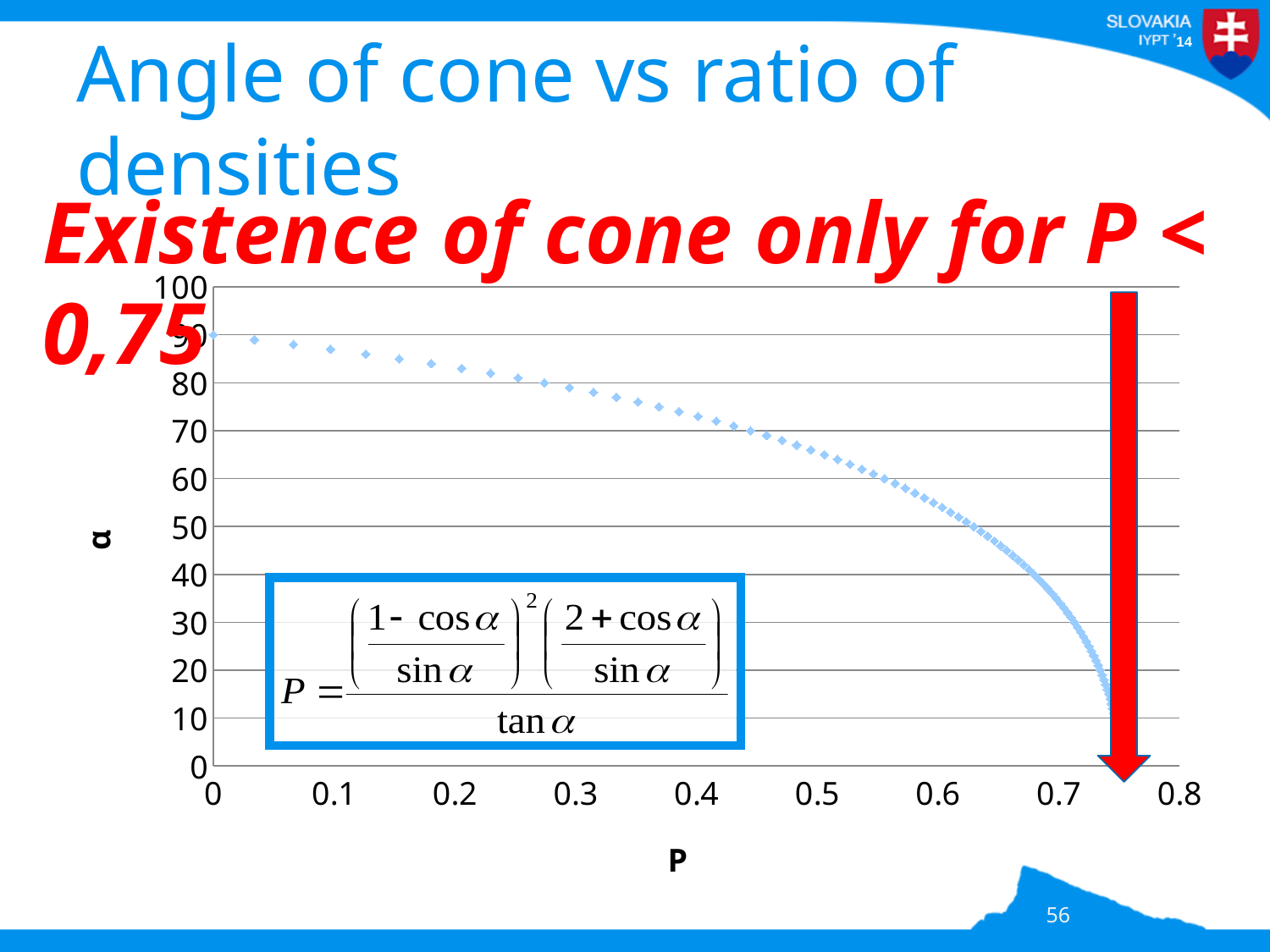
What is the value of α at P = 0? 90 Is the value of α at P = 0.6 greater or less than 60? less Is the value of α at P = 0.7 greater or less than 50? less Is the value of α at P = 0.2 greater or less than 80? greater What is the label of the x axis? P What kind of chart is shown on the slide? scatter chart At which value of P is α highest? 0 Which is larger, the value of α at P = 0.1 or at P = 0.6? P = 0.1 What is the label of the y axis? α Do the plotted values of α rise or fall as P increases along the x axis? fall